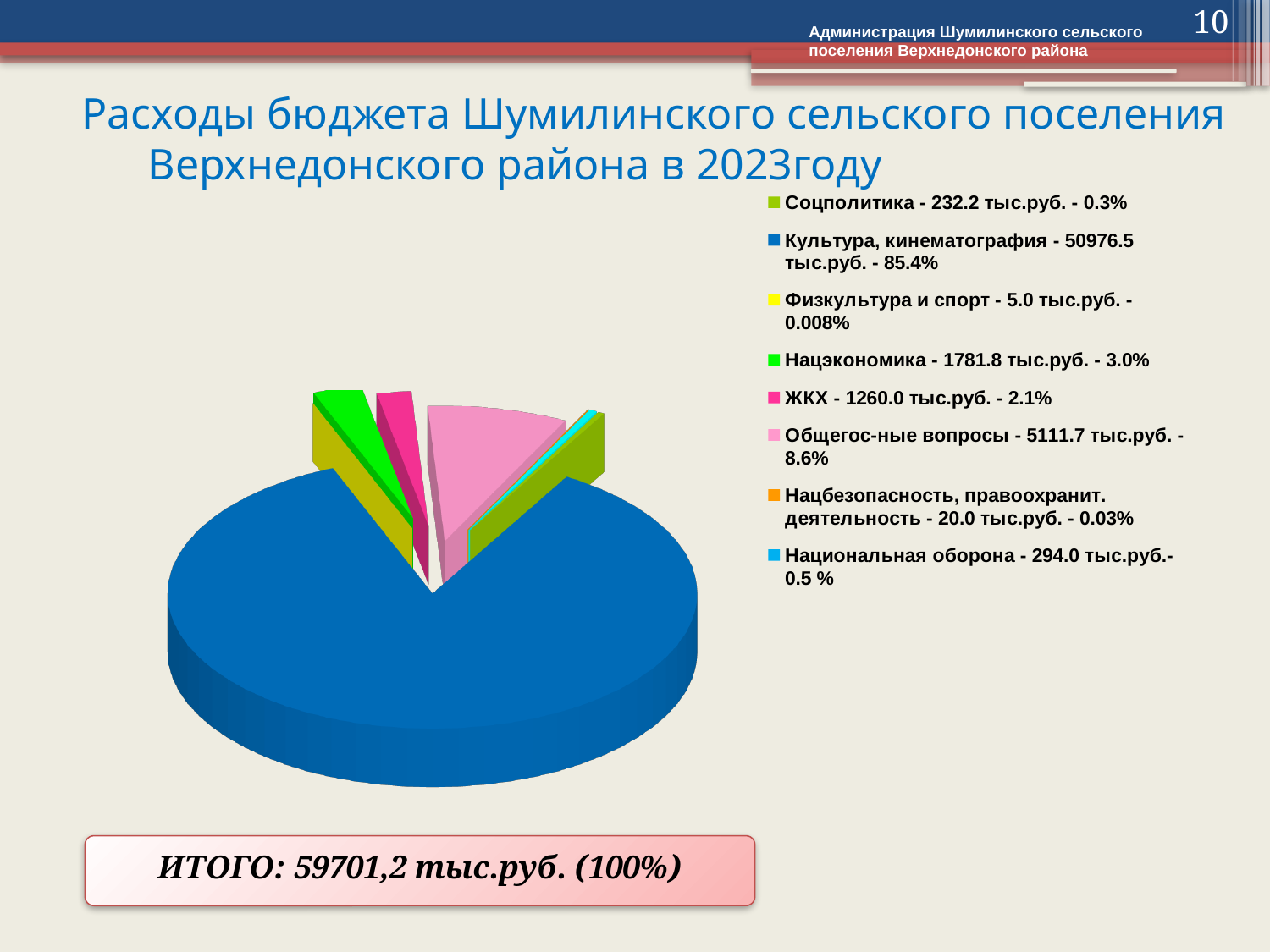
Which category has the largest value? Культура, кинематография Which is larger, ЖКХ or Нацэкономика? Нацэкономика How many categories does the legend of the pie chart list? 8 What is the value for Культура, кинематография? 50976.5 тыс.руб. What is the total (ИТОГО) of budget expenditures shown on the slide? 59701,2 тыс.руб. What is the value for ЖКХ? 1260.0 тыс.руб. What kind of chart is shown on the slide? Pie chart Which category has the smallest value? Физкультура и спорт What is the value for Нацэкономика? 1781.8 тыс.руб. What share of the pie does Национальная оборона represent? 0.5 % What share of the pie does Общегос-ные вопросы represent? 8.6% What is the difference between Общегос-ные вопросы and Нацэкономика? 3329.9 тыс.руб.